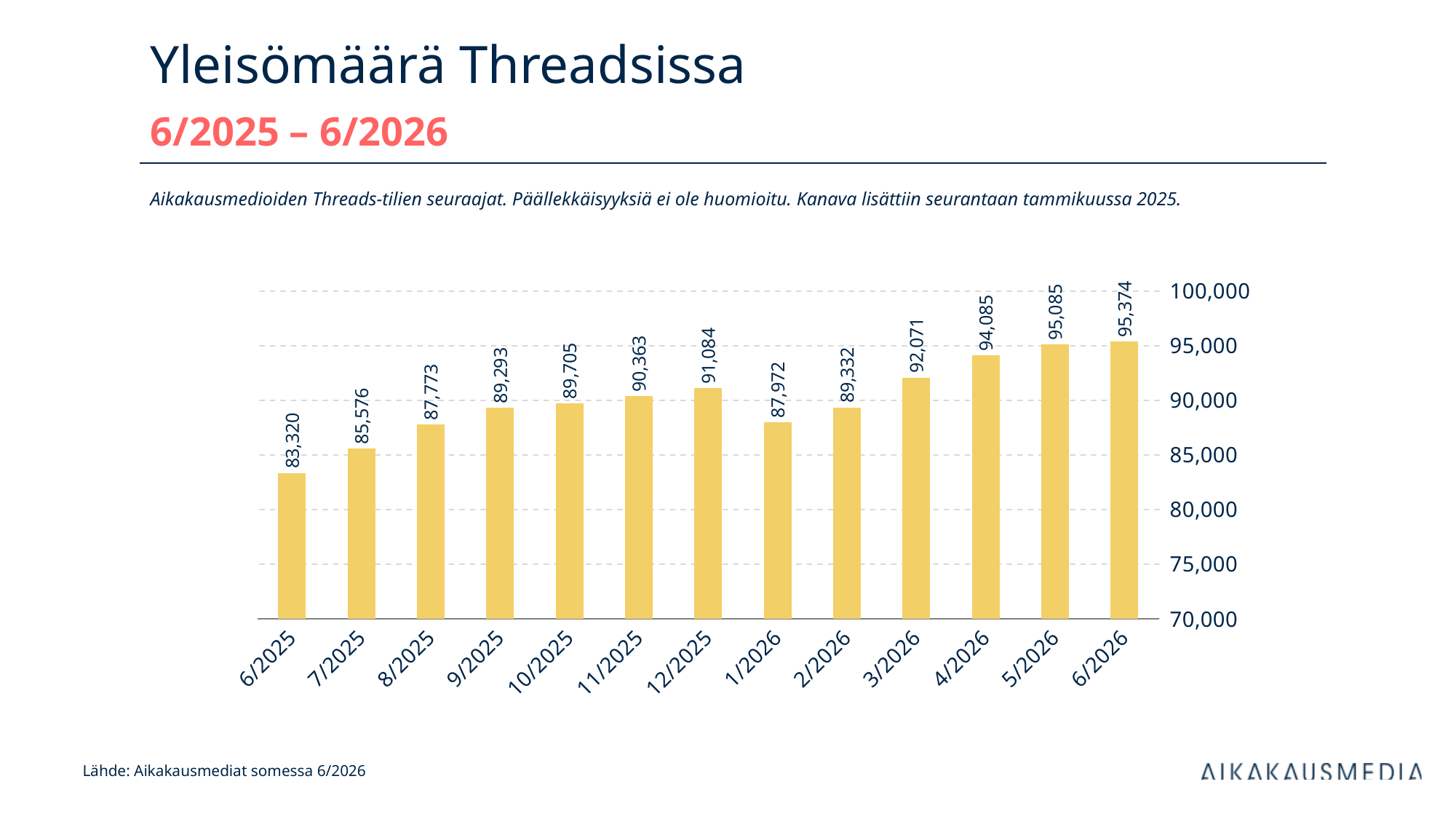
What is the title of the slide? Yleisömäärä Threadsissa Which month has the highest value? 6/2026 What is the difference between the values for 12/2025 and 1/2026? 3,112 Which month has the lowest value? 6/2025 What is the value for 1/2026? 87,972 Which is larger, the value for 12/2025 or the value for 2/2026? 12/2025 What is the difference between the values for 6/2026 and 6/2025? 12,054 How many months are shown on the x axis? 13 What kind of chart is shown on the slide? bar chart What is the value for 3/2026? 92,071 Is the value for 4/2026 greater or less than 90,000? greater What is the value for 6/2025? 83,320